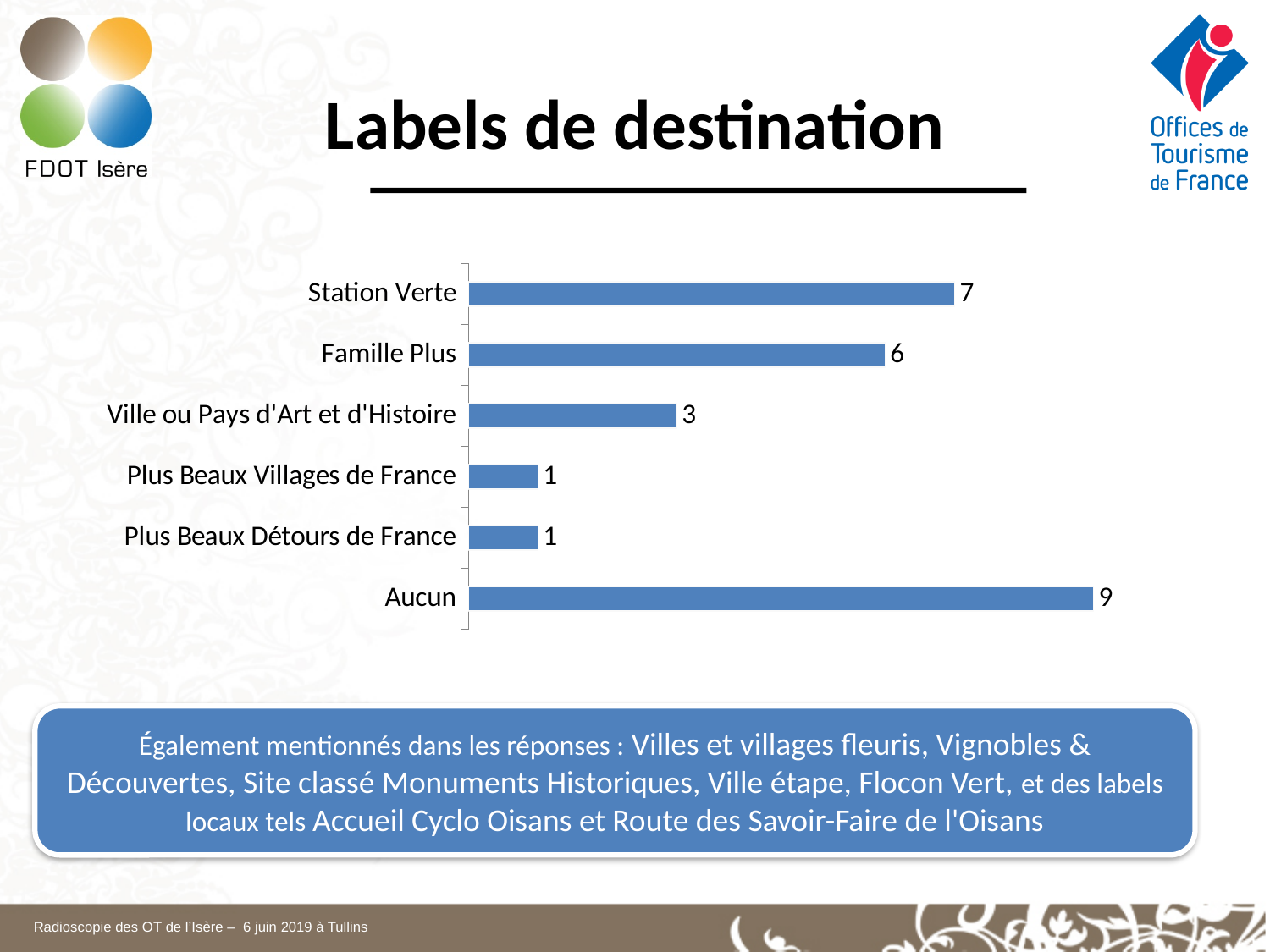
What is the value for Famille Plus? 6 What kind of chart is shown on the slide? bar chart What is the value for Station Verte? 7 What is the value for Plus Beaux Villages de France? 1 How many categories are shown in the chart? 6 What is the difference between the values for Famille Plus and Ville ou Pays d'Art et d'Histoire? 3 What is the value for Ville ou Pays d'Art et d'Histoire? 3 What is the title of the slide containing the chart? Labels de destination Which is larger, the value for Station Verte or the value for Famille Plus? Station Verte What is the difference between the values for Aucun and Station Verte? 2 Which category has the highest value? Aucun What is the value for Aucun? 9